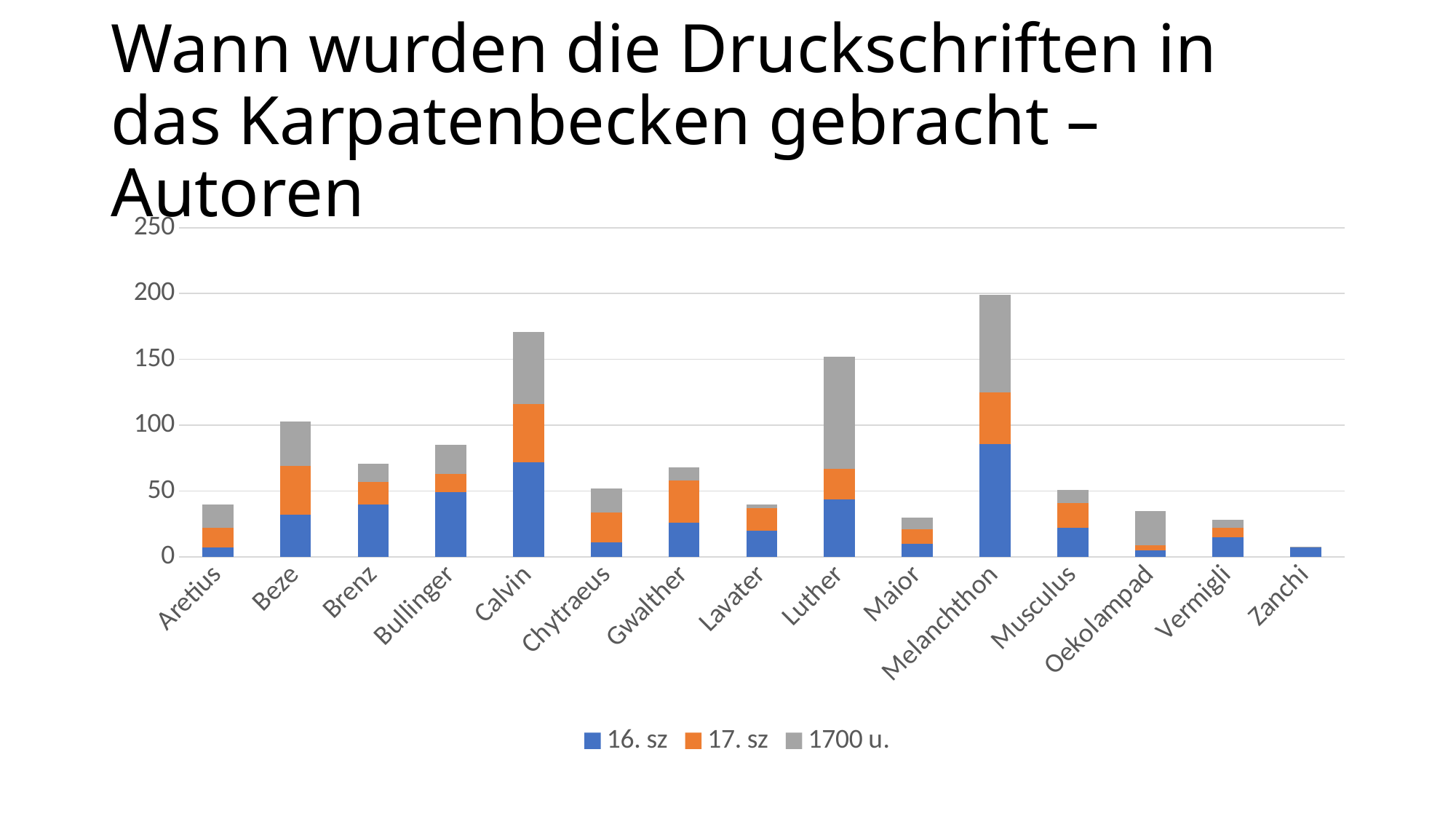
Is the 16. sz segment for Melanchthon greater or less than 50? greater What kind of chart is shown on the slide? stacked bar chart What are the three series names listed in the chart's legend? 16. sz, 17. sz, 1700 u. Which author has the lowest total bar in the chart? Zanchi Which has the larger total bar, Beze or Brenz? Beze Which author has the highest total bar in the chart? Melanchthon Is the total bar for Calvin greater or less than 150? greater Is the total bar for Bullinger greater or less than 100? less Which has the larger total bar, Calvin or Luther? Calvin How many series does the chart's legend list? 3 How many authors (categories) are shown on the x axis of the chart? 15